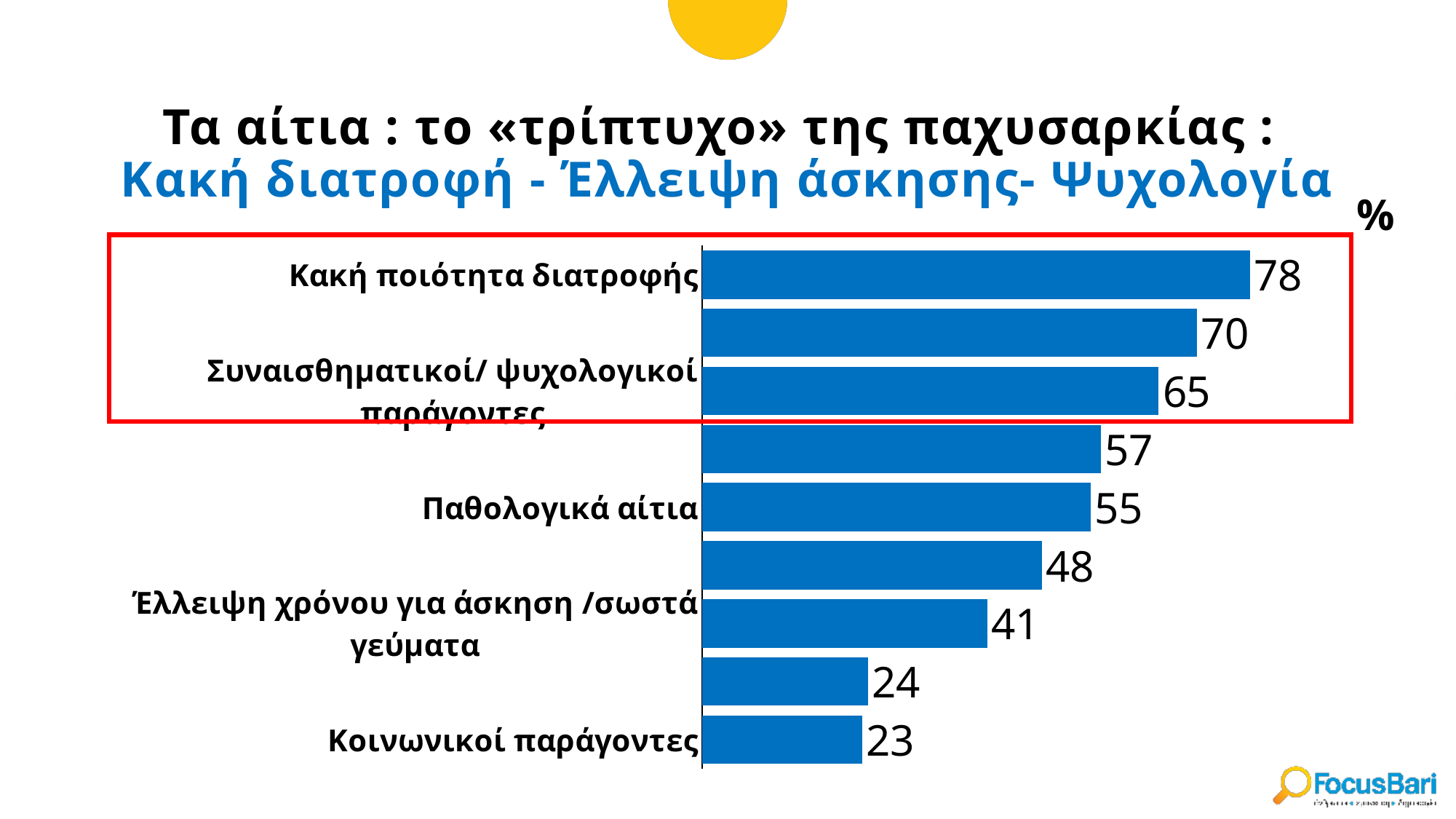
Which category has the highest value? Κακή ποιότητα διατροφής How many bars does the chart contain? 9 What unit symbol is shown at the top right of the chart? % What is the value for Κακή ποιότητα διατροφής? 78 Which category has the lowest value? Κοινωνικοί παράγοντες What is the highest value shown in the chart? 78 What kind of chart is shown on the slide? bar chart What is the value for Παθολογικά αίτια? 55 What is the difference between the values for Κακή ποιότητα διατροφής and Παθολογικά αίτια? 23 What is the value for Έλλειψη χρόνου για άσκηση /σωστά γεύματα? 41 Which is larger, the value for Παθολογικά αίτια or the value for Έλλειψη χρόνου για άσκηση /σωστά γεύματα? Παθολογικά αίτια What is the value for Κοινωνικοί παράγοντες? 23